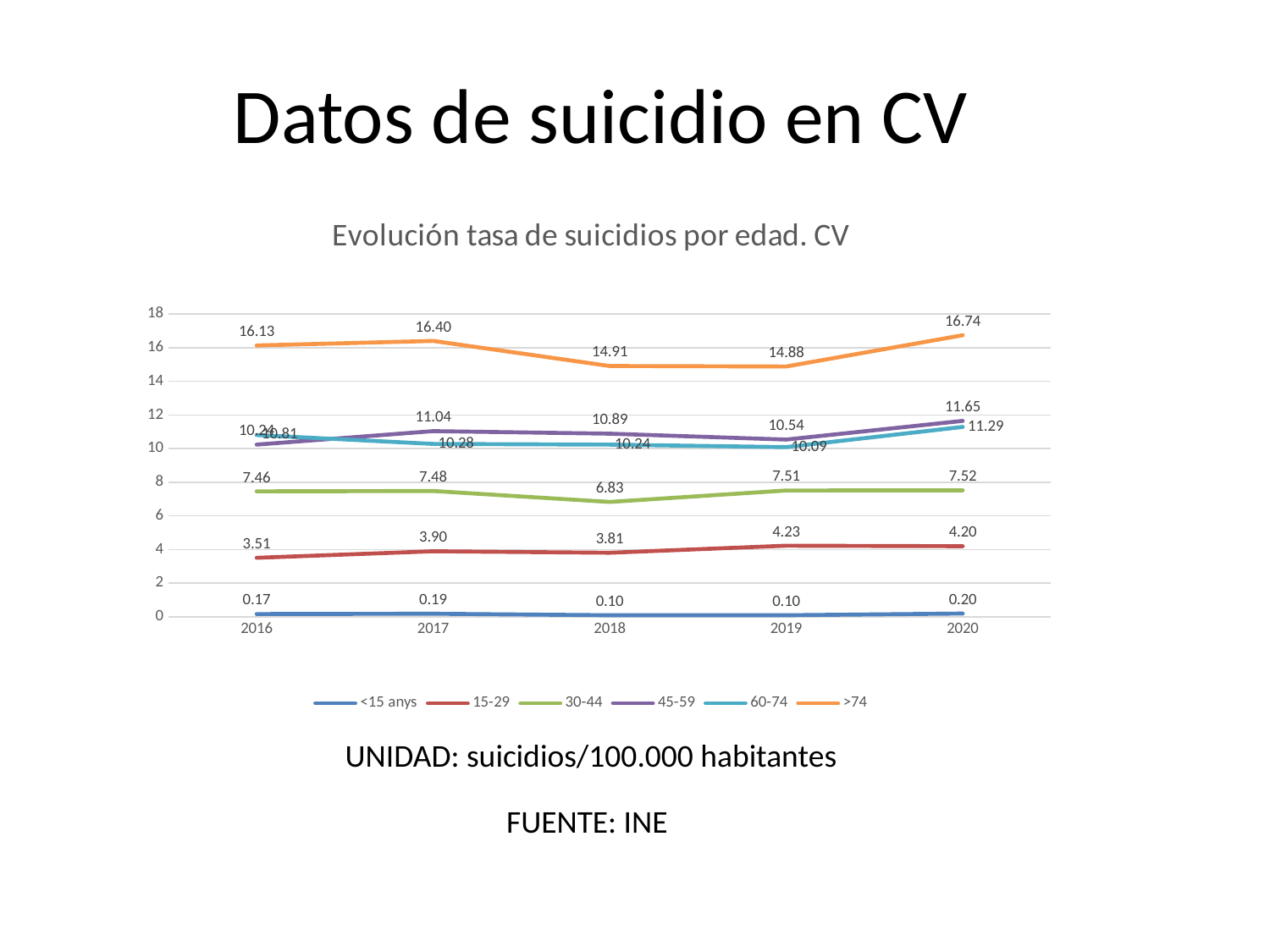
Which series has the larger value in 2020, 45-59 or 60-74? 45-59 What kind of chart is shown on the slide? line chart How many series does the legend list? 6 What is the title of the chart? Evolución tasa de suicidios por edad. CV In which year is the 45-59 series at its highest value? 2020 What is the difference between the >74 values in 2017 and 2018? 1.49 What is the value for the >74 series in 2020? 16.74 What is the value for the 30-44 series in 2018? 6.83 In which year is the >74 series at its lowest value? 2019 Does the 15-29 series rise or fall from 2016 to 2019? rise How many years are shown on the x axis? 5 What is the value for the 15-29 series in 2019? 4.23